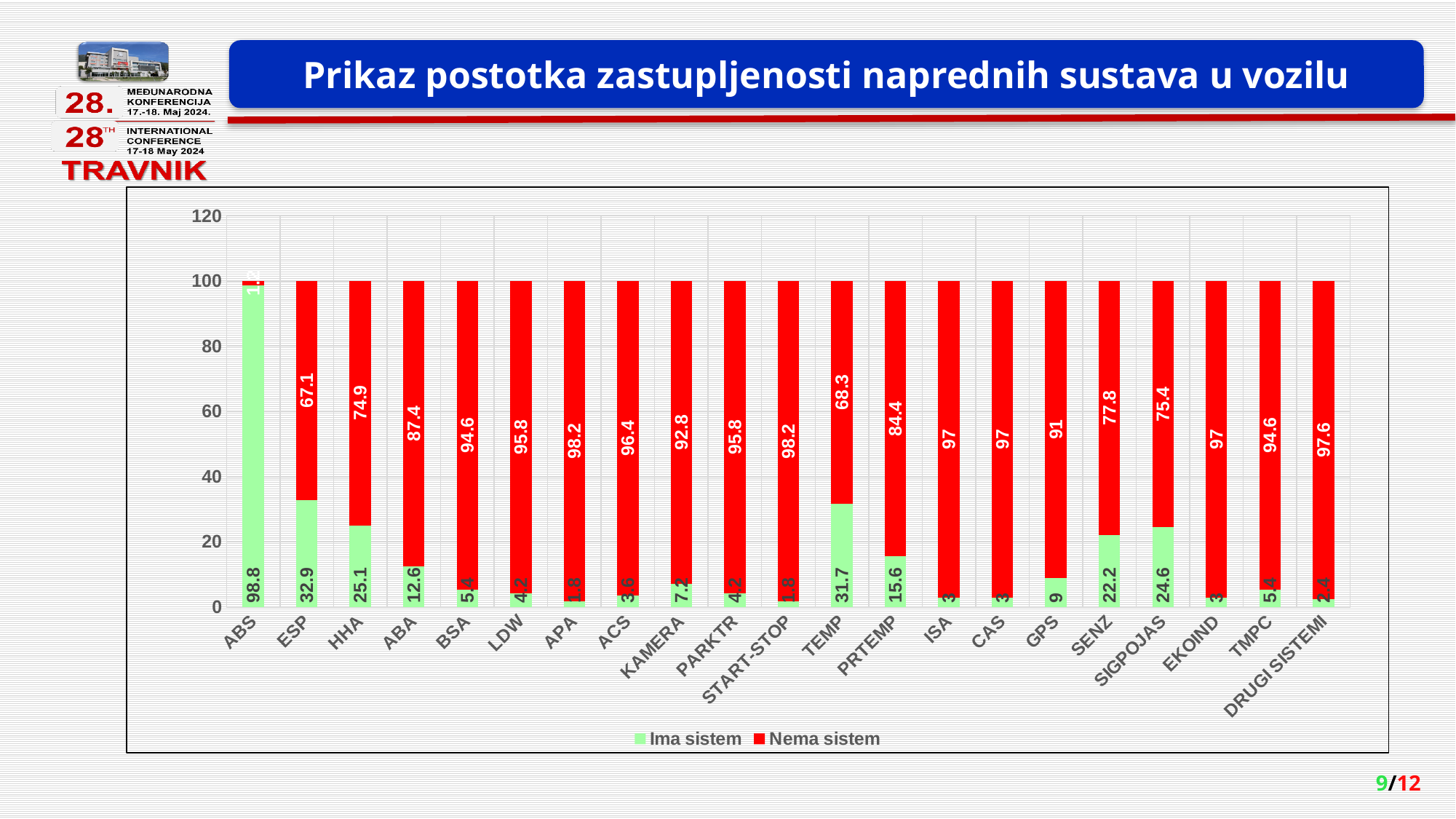
What is the Ima sistem value for ESP? 32.9 Which category has the highest Ima sistem value? ABS What is the Ima sistem value for SIGPOJAS? 24.6 Is the Nema sistem value for ESP greater or less than 60? greater What is the Nema sistem value for HHA? 74.9 Which category has the lowest Nema sistem value? ABS Which has a larger Ima sistem value, ESP or HHA? ESP What is the total of the stacked bar for ESP? 100 What is the difference between the Ima sistem values for ESP and TEMP? 1.2 What kind of chart is shown on the slide? Stacked bar chart How many series does the legend list? 2 How many categories are shown on the x axis? 21